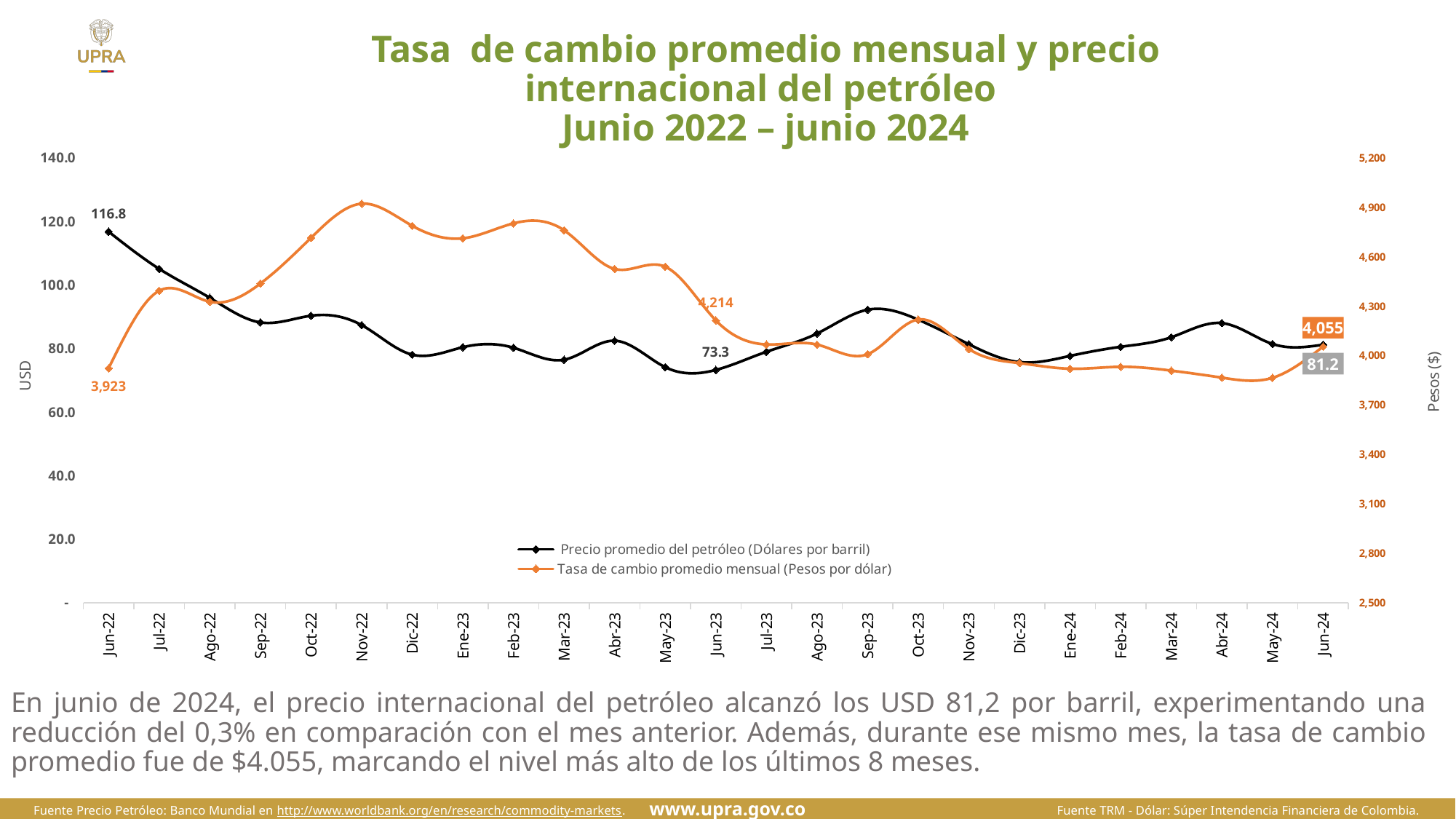
What was the average oil price in Jun-24? 81.2 In which month was the average monthly exchange rate highest? Nov-22 What was the average monthly exchange rate (Pesos por dólar) in Jun-22? 3,923 What was the average monthly exchange rate in Jun-23? 4,214 By how much did the average oil price fall from Jun-22 to Jun-24? 35.6 What was the average monthly exchange rate in Jun-24? 4,055 What kind of chart is shown on the slide? Line chart In which month was the average oil price highest? Jun-22 Is the average oil price for Nov-22 greater or less than 100.0? less What was the average oil price (Dólares por barril) in Jun-22? 116.8 What was the average oil price in Jun-23? 73.3 How many series does the legend list? 2